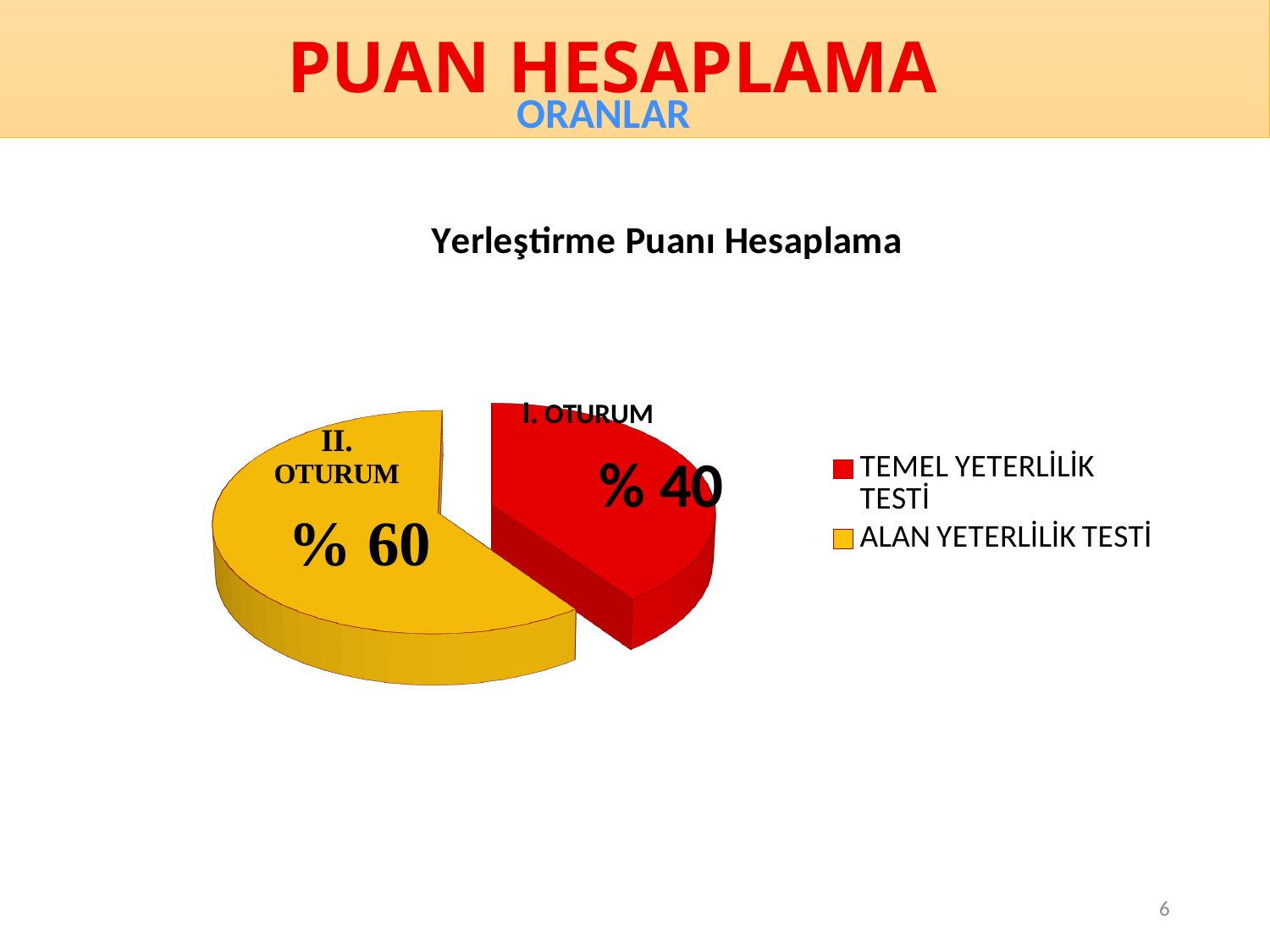
What is the chart's title? Yerleştirme Puanı Hesaplama Which legend entry corresponds to the red slice? TEMEL YETERLİLİK TESTİ Which slice is the largest? II. OTURUM Which is larger, the I. OTURUM slice or the II. OTURUM slice? II. OTURUM What is the difference between the II. OTURUM and I. OTURUM values? % 20 What value is shown for the II. OTURUM slice? % 60 How many slices does the pie chart have? 2 What share of the pie does the ALAN YETERLİLİK TESTİ slice represent? % 60 How many entries does the legend list? 2 What value is shown for the I. OTURUM slice? % 40 Which slice is the smallest? I. OTURUM What kind of chart is shown on the slide? pie chart